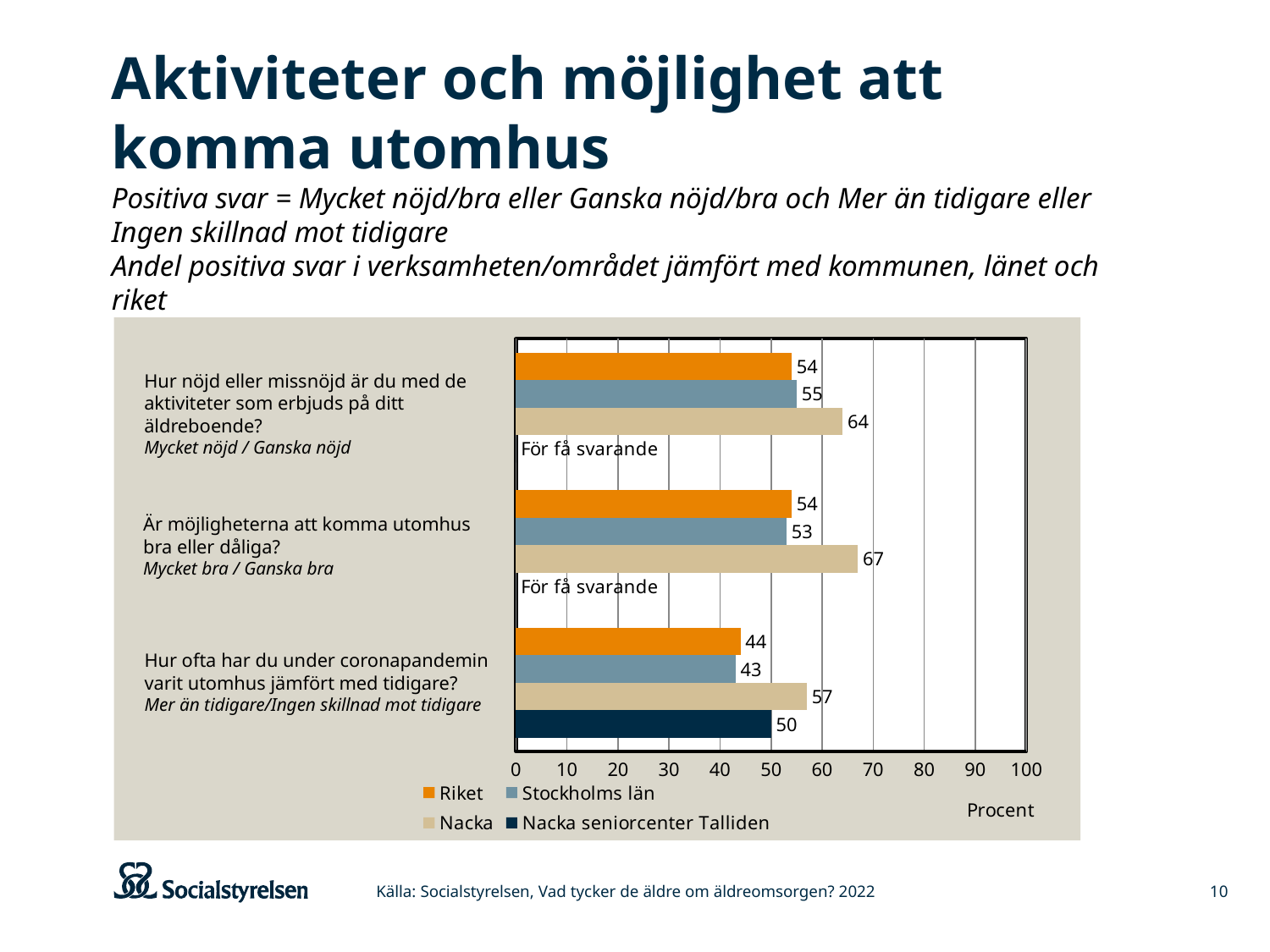
What is the value for Stockholms län on the question 'Hur nöjd eller missnöjd är du med de aktiviteter som erbjuds på ditt äldreboende?' 55 What type of chart is shown on the slide? bar chart What is the difference between Nacka and Riket on the question 'Är möjligheterna att komma utomhus bra eller dåliga?' 13 What is the value for Nacka seniorcenter Talliden on the question 'Hur ofta har du under coronapandemin varit utomhus jämfört med tidigare?' 50 How many question categories are shown on the chart? 3 Which series has the lowest value on the question 'Hur ofta har du under coronapandemin varit utomhus jämfört med tidigare?' Stockholms län How many series does the legend list? 4 Which is larger on the question 'Hur ofta har du under coronapandemin varit utomhus jämfört med tidigare?': Nacka or Nacka seniorcenter Talliden? Nacka What is shown instead of a bar for Nacka seniorcenter Talliden on the first two questions? För få svarande Which series has the highest value on the question 'Hur nöjd eller missnöjd är du med de aktiviteter som erbjuds på ditt äldreboende?' Nacka What is the value for Nacka on the question 'Är möjligheterna att komma utomhus bra eller dåliga?' 67 What is the value for Riket on the question 'Hur ofta har du under coronapandemin varit utomhus jämfört med tidigare?' 44